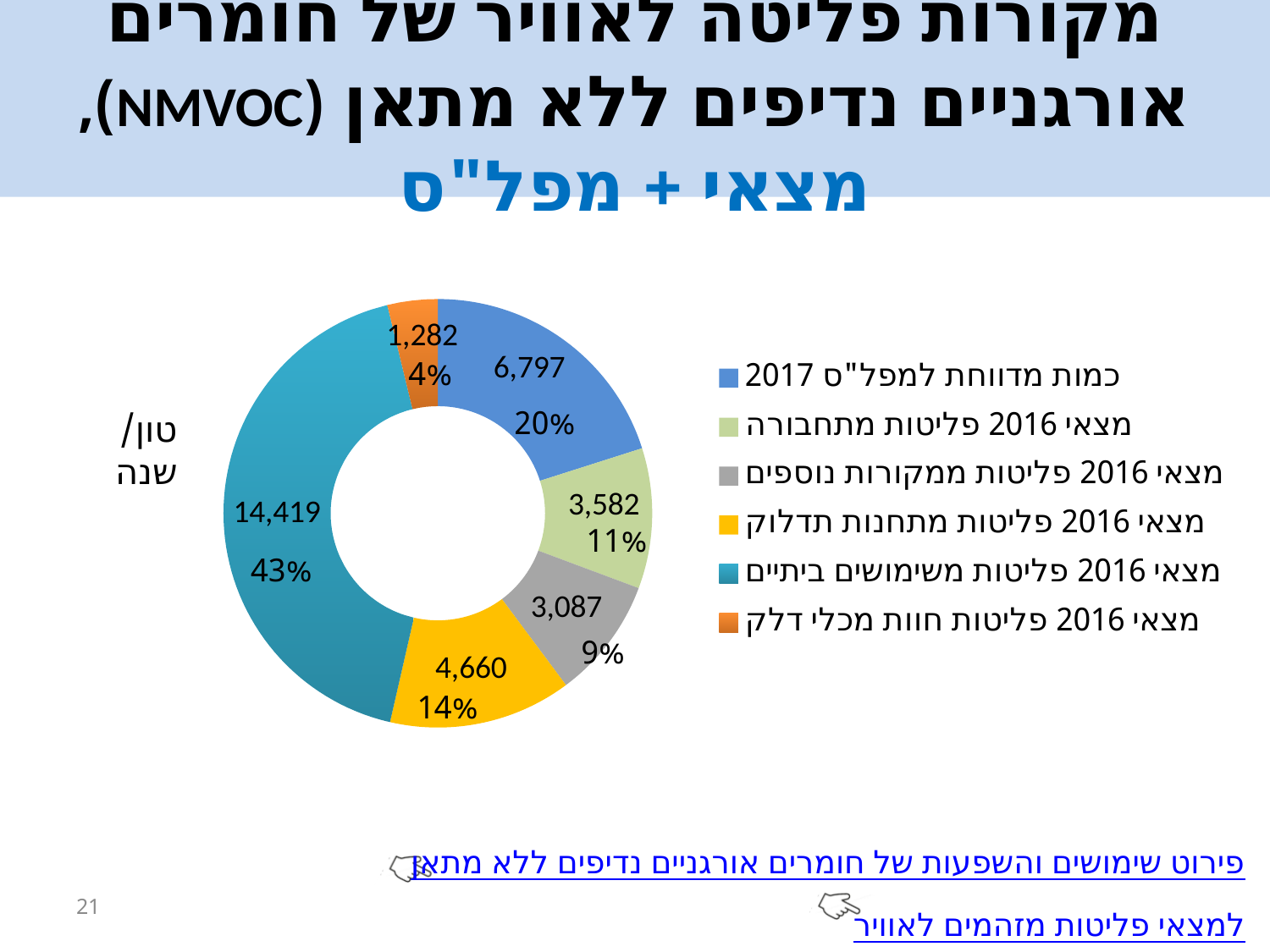
What share of the chart does מצאי 2016 פליטות ממקורות נוספים represent? 9% What is the value for מצאי 2016 פליטות משימושים ביתיים? 14,419 What is the value for כמות מדווחת למפל"ס 2017? 6,797 What is the difference between the values for מצאי 2016 פליטות מתחבורה and מצאי 2016 פליטות ממקורות נוספים? 495 Which category has the smallest share of the chart? מצאי 2016 פליטות חוות מכלי דלק What kind of chart is shown on the slide? Doughnut (pie) chart Which is larger: the value for כמות מדווחת למפל"ס 2017 or the value for מצאי 2016 פליטות מתחנות תדלוק? כמות מדווחת למפל"ס 2017 What share of the chart does מצאי 2016 פליטות מתחבורה represent? 11% What is the value for מצאי 2016 פליטות מתחנות תדלוק? 4,660 What is the value for מצאי 2016 פליטות חוות מכלי דלק? 1,282 Which category has the largest share of the chart? מצאי 2016 פליטות משימושים ביתיים How many categories does the legend list? 6